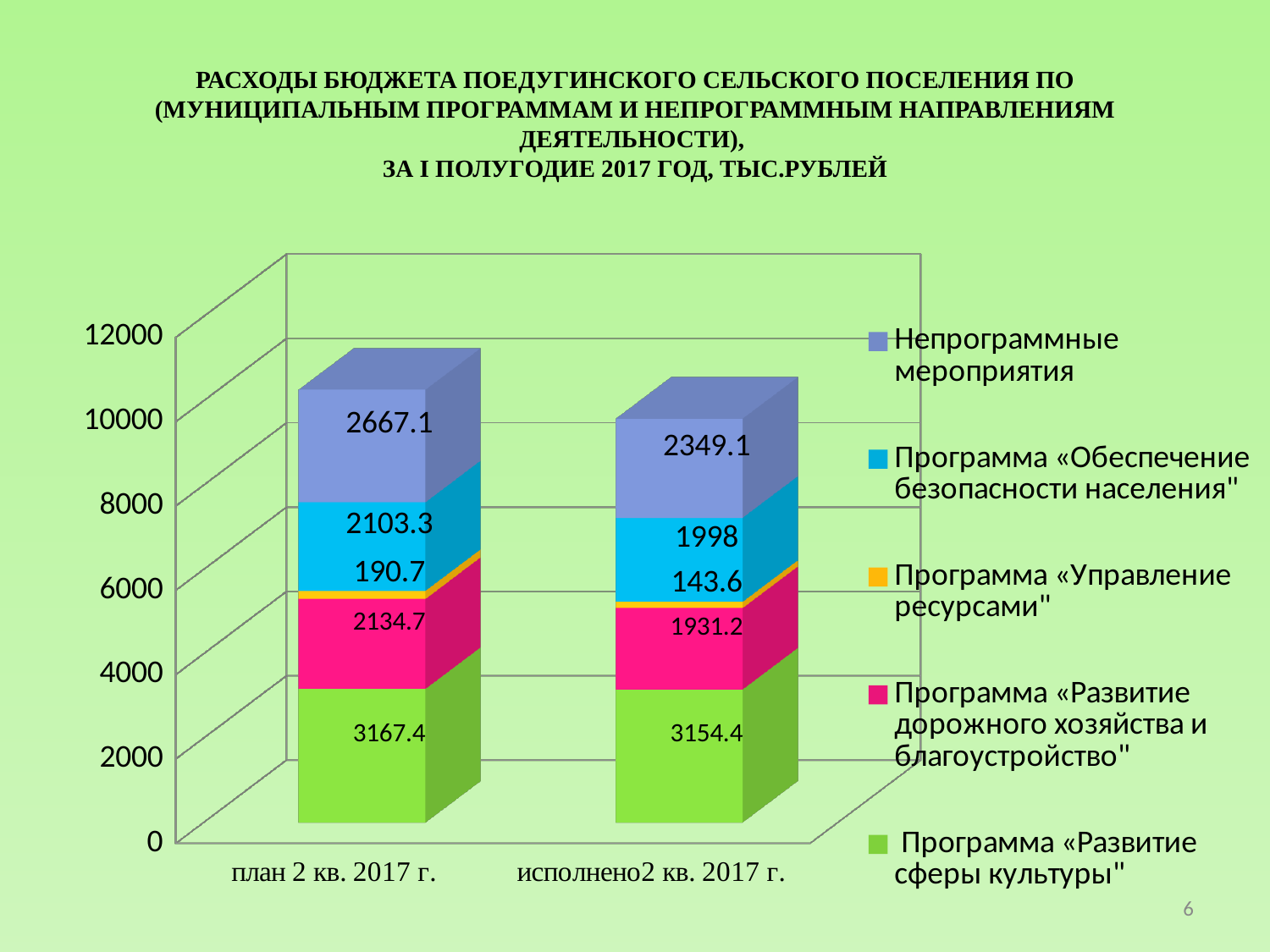
Which is larger: the «Программа «Развитие дорожного хозяйства и благоустройство»» value for «план 2 кв. 2017 г.» or for «исполнено2 кв. 2017 г.»? план 2 кв. 2017 г. What is the difference between the «план 2 кв. 2017 г.» and «исполнено2 кв. 2017 г.» values for «Непрограммные мероприятия»? 318 Which series has the smallest value in the «исполнено2 кв. 2017 г.» bar? Программа «Управление ресурсами» How many series does the legend list? 5 Which series has the largest value in the «план 2 кв. 2017 г.» bar? Программа «Развитие сферы культуры» What is the total of the «исполнено2 кв. 2017 г.» stacked bar? 9576.3 How many categories are shown on the x axis? 2 What is the value for «Программа «Обеспечение безопасности населения»» in the «исполнено2 кв. 2017 г.» bar? 1998 What kind of chart is shown on the slide? Stacked bar chart What is the value for «Программа «Развитие сферы культуры»» in the «исполнено2 кв. 2017 г.» bar? 3154.4 What is the value for «Программа «Управление ресурсами»» in the «план 2 кв. 2017 г.» bar? 190.7 What is the value for «Непрограммные мероприятия» in the «план 2 кв. 2017 г.» bar? 2667.1